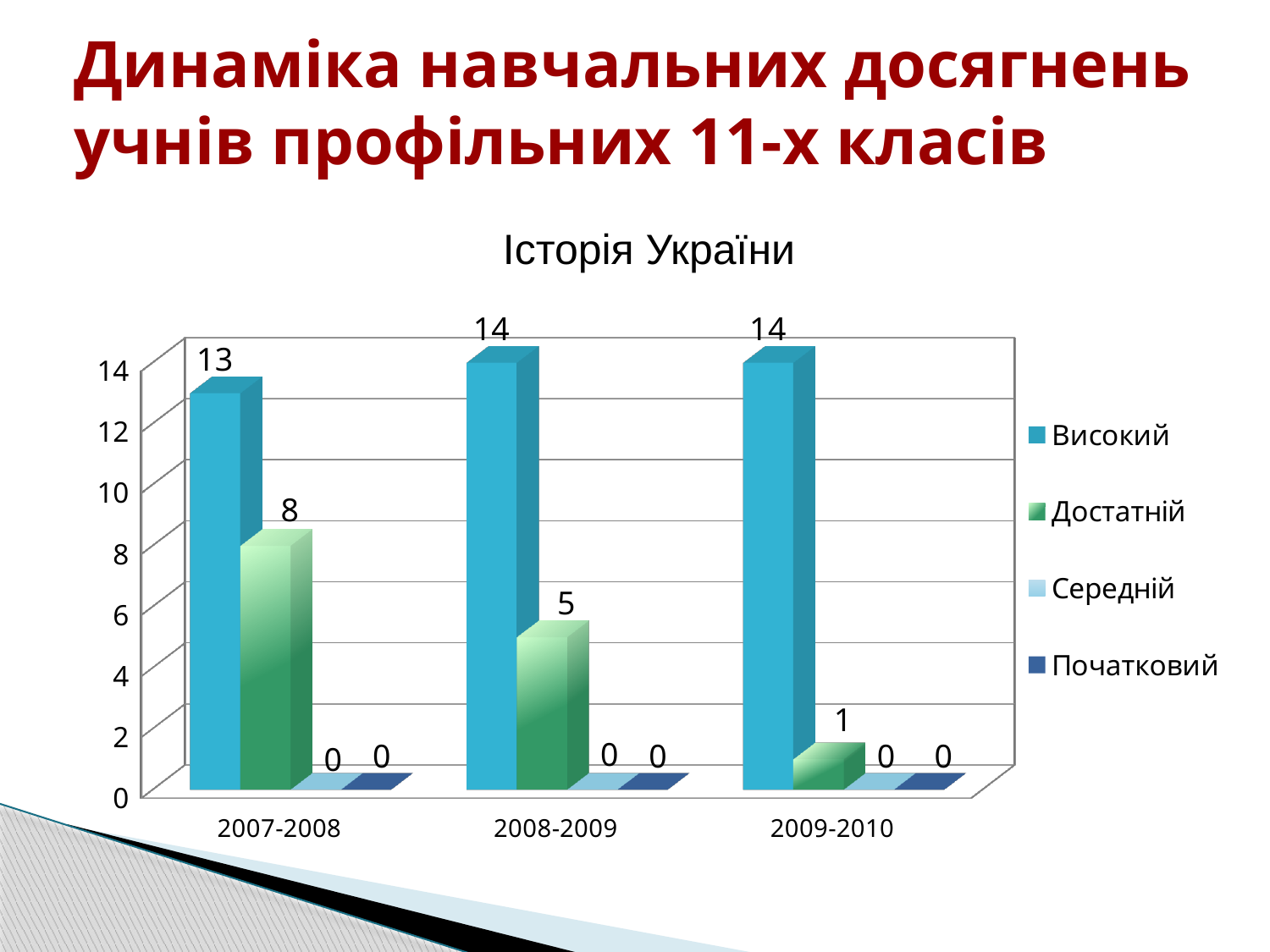
What kind of chart is shown? bar chart What is the value for Високий in 2007-2008? 13 Which is larger in 2008-2009: Високий or Достатній? Високий Does the value for Достатній rise or fall from 2007-2008 to 2009-2010? fall What is the value for Середній in 2007-2008? 0 How many year categories are shown on the x axis? 3 What is the value for Достатній in 2009-2010? 1 In which year is the value for Достатній highest? 2007-2008 What is the value for Достатній in 2008-2009? 5 How many series does the legend list? 4 In which year is the value for Достатній lowest? 2009-2010 What is the difference between Високий and Достатній in 2007-2008? 5